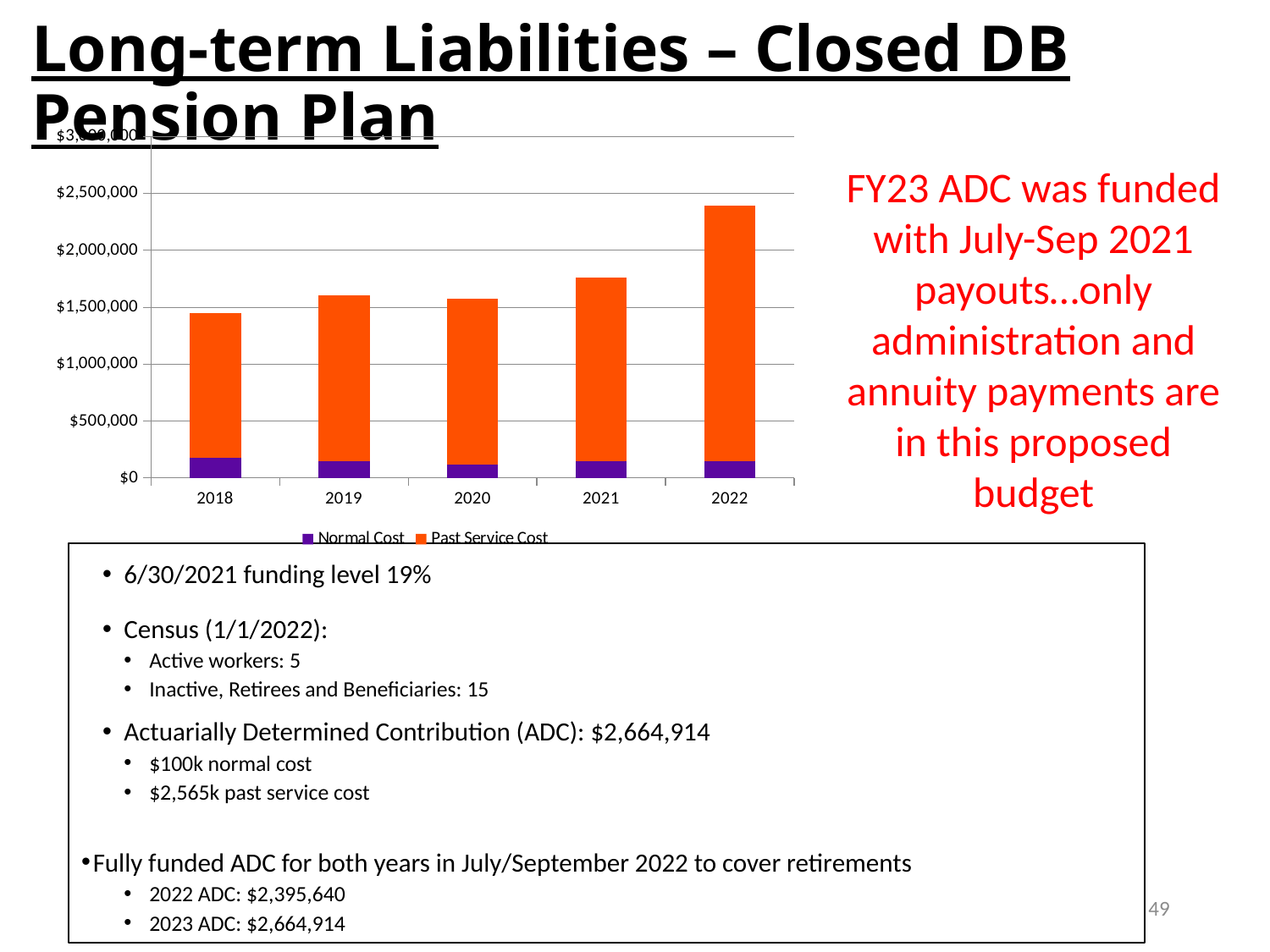
Which year has the highest total bar in the chart? 2022 Which year has the lowest total bar in the chart? 2018 Is the total value for 2022 greater or less than $2,000,000? greater Which has the larger total bar, 2018 or 2022? 2022 Which series is shown in orange in the chart? Past Service Cost Is the total value for 2018 greater or less than $1,500,000? less What kind of chart is shown on the slide? Stacked bar chart Which has the larger total bar, 2021 or 2019? 2021 Do the total bar values generally rise or fall from 2018 to 2022? rise How many series does the chart legend list? 2 How many years are shown on the x axis of the chart? 5 Is the total value for 2021 greater or less than $1,500,000? greater